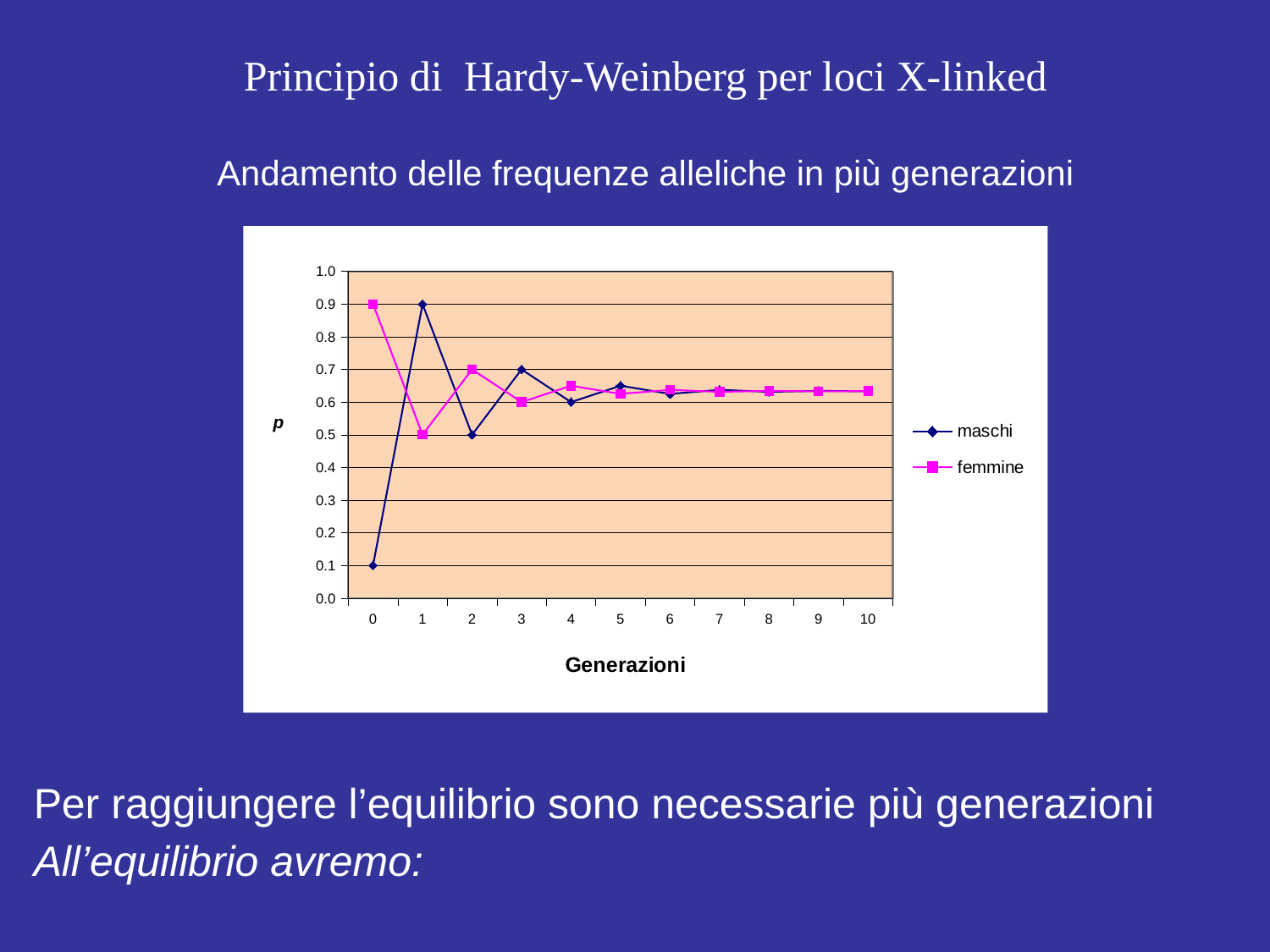
How many generations are plotted along the x axis? 11 What is the value of p for maschi at generation 1? 0.9 What is the label of the x axis? Generazioni What is the value of p for femmine at generation 0? 0.9 What kind of chart is shown on the slide? line chart What is the value of p for femmine at generation 1? 0.5 What is the difference between the femmine and maschi values of p at generation 0? 0.8 At which generation does the maschi series reach its lowest value of p? 0 At generation 0, which series has the higher value of p, maschi or femmine? femmine What is the value of p for maschi at generation 0? 0.1 What are the names of the two series in the legend? maschi and femmine How many series does the chart legend list? 2